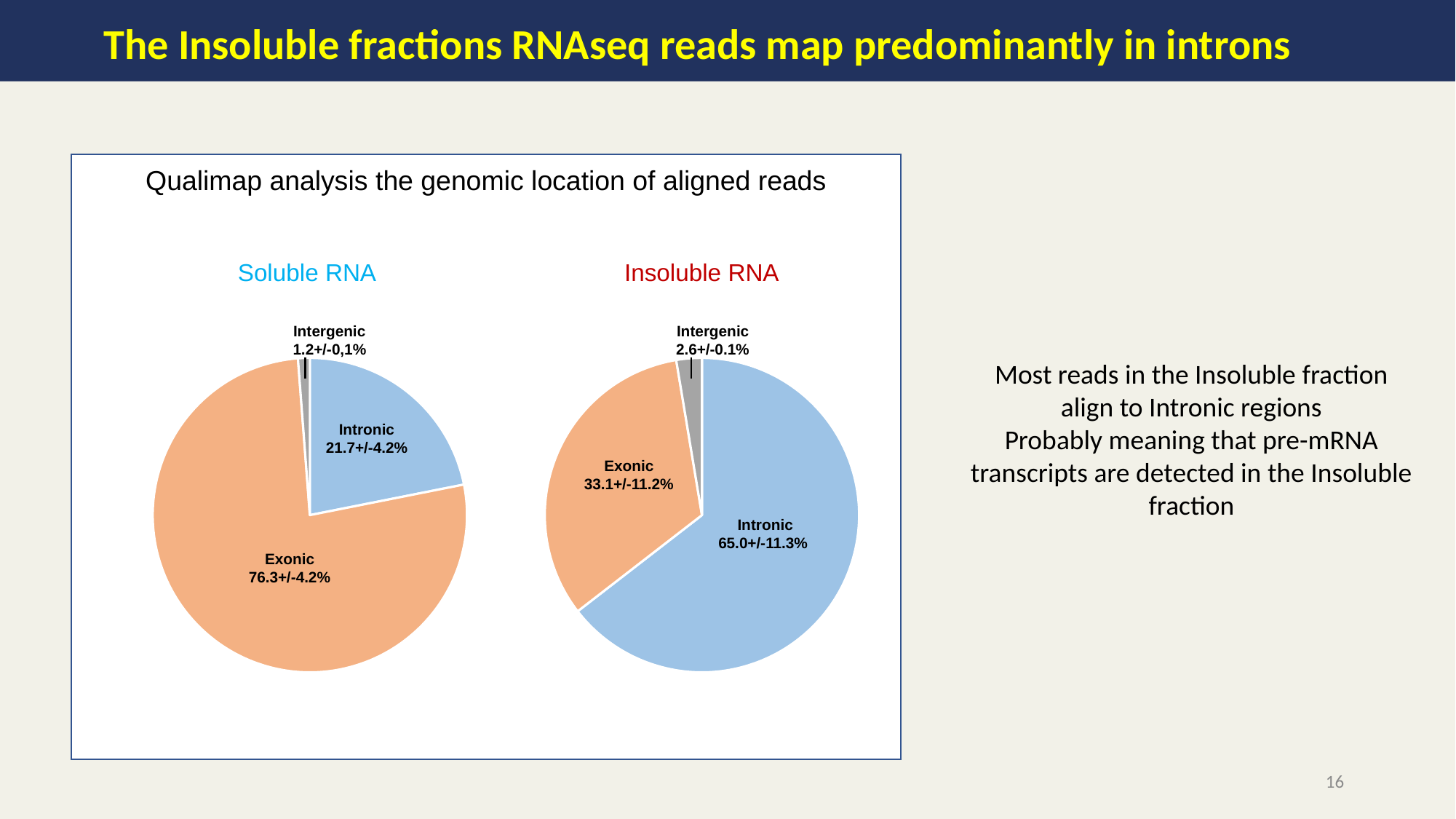
What kind of charts are shown on the slide? Pie charts In the Insoluble RNA pie chart, what is the value labelled for the Intronic slice? 65.0+/-11.3% In the Insoluble RNA pie chart, what is the value labelled for the Exonic slice? 33.1+/-11.2% In the Soluble RNA pie chart, which slice is the largest? Exonic How many pie charts are shown on the slide? 2 In the Soluble RNA pie chart, what is the value labelled for the Intronic slice? 21.7+/-4.2% In the Insoluble RNA pie chart, which slice is the largest? Intronic How many slices does each pie chart have? 3 Which pie chart has the larger Intronic slice, Soluble RNA or Insoluble RNA? Insoluble RNA In the Insoluble RNA pie chart, which slice is the smallest? Intergenic In the Insoluble RNA pie chart, what is the value labelled for the Intergenic slice? 2.6+/-0.1% In the Soluble RNA pie chart, what is the value labelled for the Exonic slice? 76.3+/-4.2%